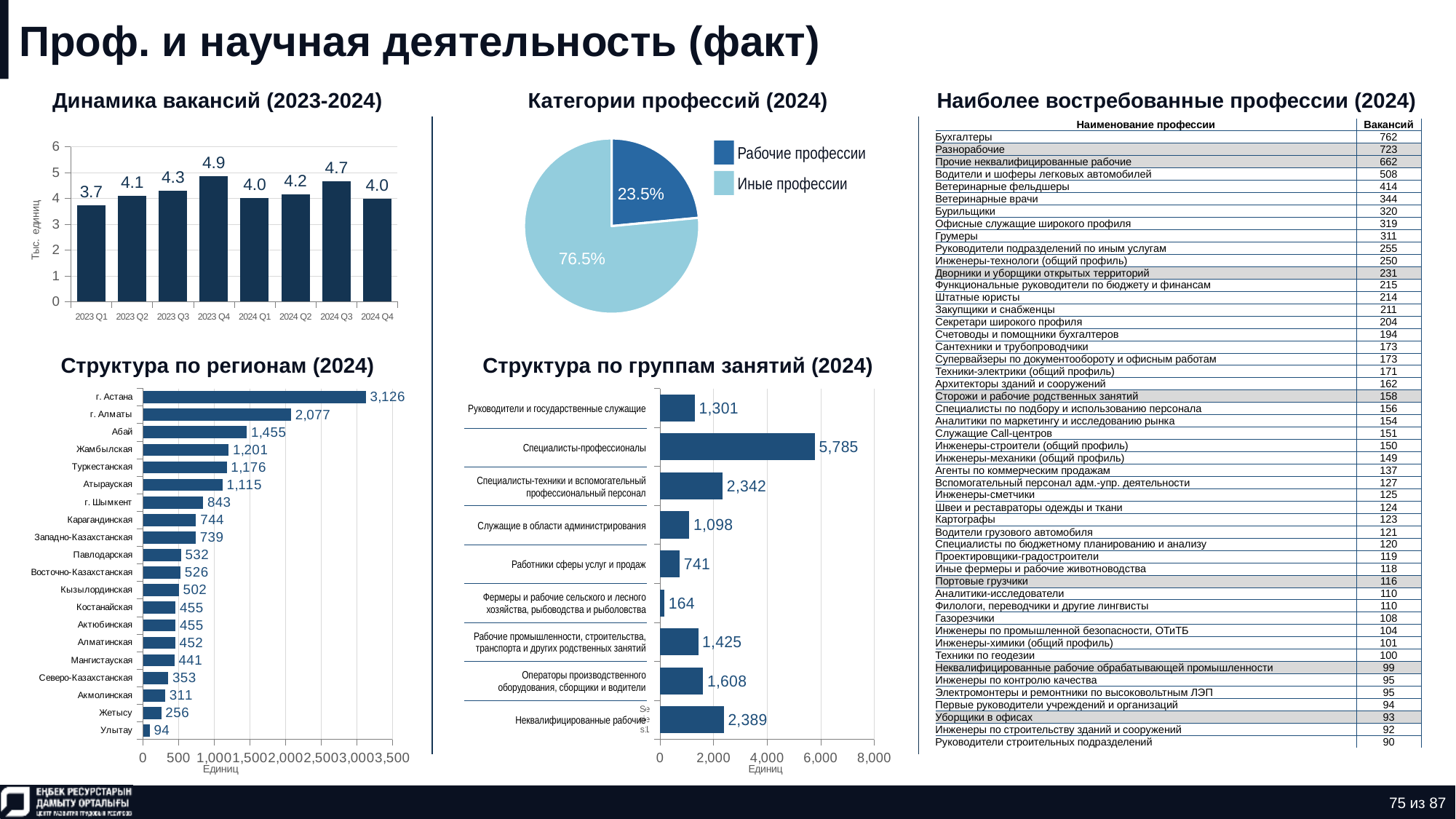
In the pie chart 'Категории профессий (2024)', how many entries does the legend list? 2 In the pie chart 'Категории профессий (2024)', what share do 'Иные профессии' have? 76.5% In the chart 'Структура по регионам (2024)', what is the value for г. Алматы? 2,077 In the chart 'Динамика вакансий (2023-2024)', which quarter has the lowest value? 2023 Q1 In the chart 'Динамика вакансий (2023-2024)', what is the value for 2023 Q4? 4.9 In the chart 'Динамика вакансий (2023-2024)', what is the difference between 2024 Q3 and 2024 Q4? 0.7 In the chart 'Структура по группам занятий (2024)', what is the value for 'Специалисты-профессионалы'? 5,785 In the chart 'Структура по регионам (2024)', which region has the highest value? г. Астана In the chart 'Структура по регионам (2024)', which region has the lowest value? Улытау In the chart 'Структура по регионам (2024)', which is larger: Жамбылская or Атырауская? Жамбылская What kind of chart is 'Структура по группам занятий (2024)'? Bar chart In the chart 'Динамика вакансий (2023-2024)', how many quarters are plotted? 8